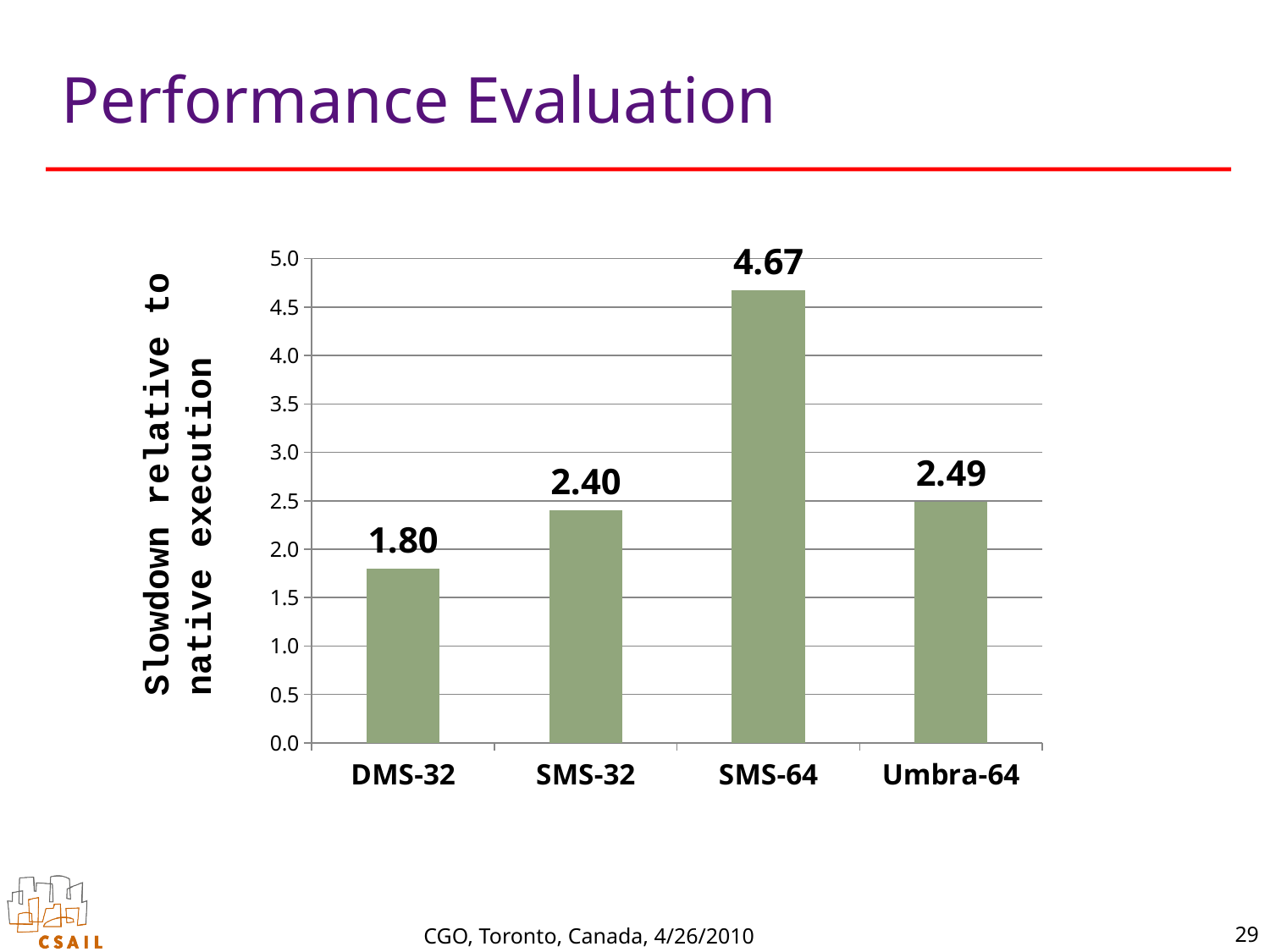
What is the value shown for Umbra-64? 2.49 Which category has the lowest slowdown? DMS-32 What is the label of the y axis? Slowdown relative to native execution What is the slowdown relative to native execution for SMS-64? 4.67 How many categories are shown on the x axis? 4 Which has a larger slowdown, SMS-32 or SMS-64? SMS-64 What is the difference between the slowdown for SMS-64 and SMS-32? 2.27 What is the slowdown relative to native execution for DMS-32? 1.80 Which category has the highest slowdown? SMS-64 What is the difference between the slowdown for Umbra-64 and DMS-32? 0.69 Is the value for SMS-64 greater or less than 4.0? greater What kind of chart is shown on the slide? bar chart